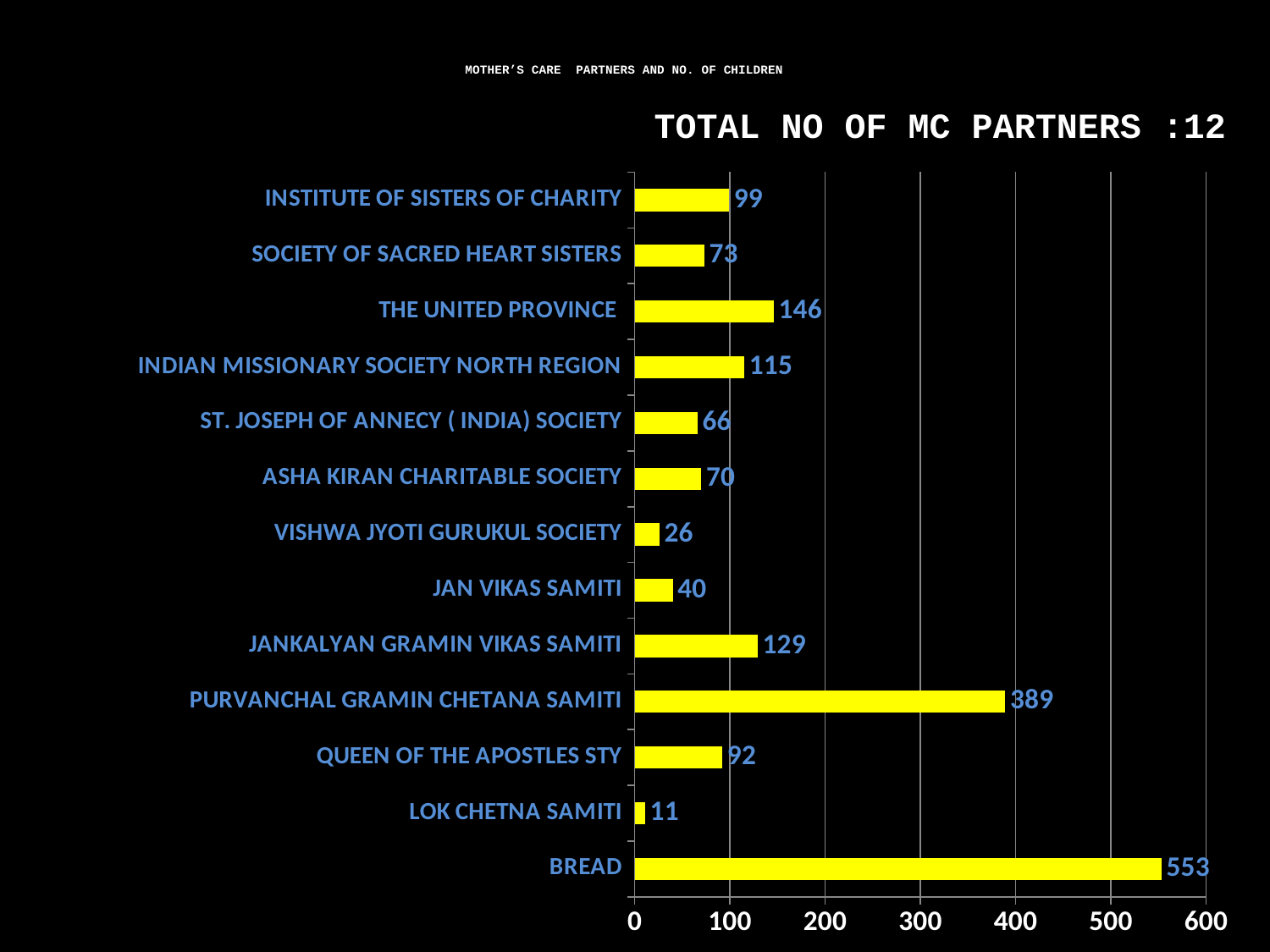
What is the value for PURVANCHAL GRAMIN CHETANA SAMITI? 389 Which category has the highest value? BREAD What is the difference between the values for INDIAN MISSIONARY SOCIETY NORTH REGION and JAN VIKAS SAMITI? 75 What is the value for QUEEN OF THE APOSTLES STY? 92 Which is larger, the value for INSTITUTE OF SISTERS OF CHARITY or the value for SOCIETY OF SACRED HEART SISTERS? INSTITUTE OF SISTERS OF CHARITY What is the difference between the values for BREAD and PURVANCHAL GRAMIN CHETANA SAMITI? 164 What is the value for VISHWA JYOTI GURUKUL SOCIETY? 26 What kind of chart is shown on the slide? Bar chart What is the value for THE UNITED PROVINCE? 146 Which category has the lowest value? LOK CHETNA SAMITI What total number of MC partners is stated above the chart? 12 How many bars are plotted in the chart? 13